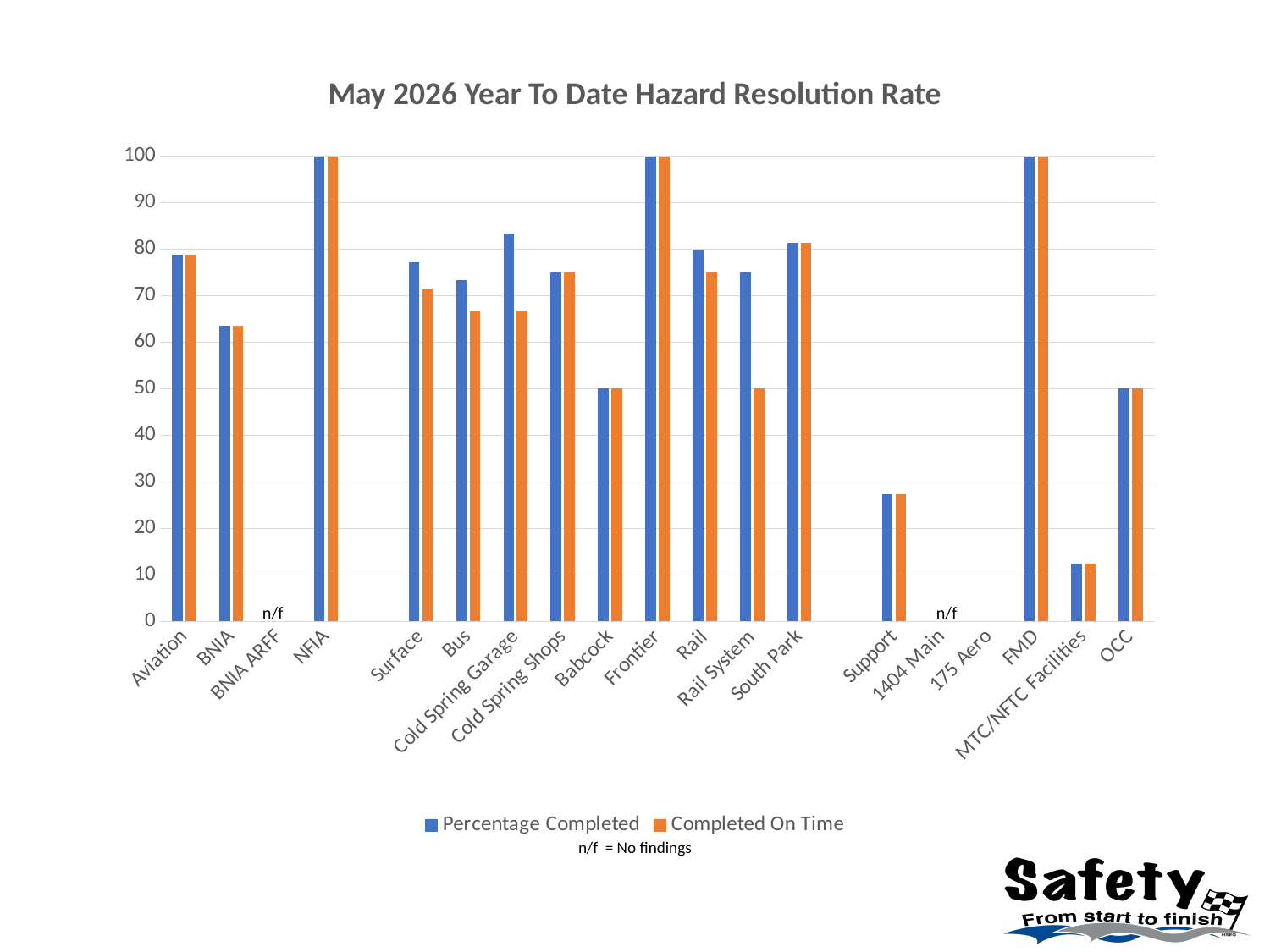
What is the Percentage Completed value for NFIA? 100 Is the Percentage Completed value for Aviation greater or less than 70? greater Is the Percentage Completed value for Support greater or less than 30? less What is the Percentage Completed value for OCC? 50 What is the Completed On Time value for Babcock? 50 How many categories are marked n/f (no findings) on the chart? 2 For Rail System, which is larger: Percentage Completed or Completed On Time? Percentage Completed What is the Completed On Time value for Rail System? 50 Is the Completed On Time value for Bus greater or less than 70? less How many series does the legend list? 2 Which category has the lowest plotted Percentage Completed value? MTC/NFTC Facilities What kind of chart is shown on the slide? bar chart